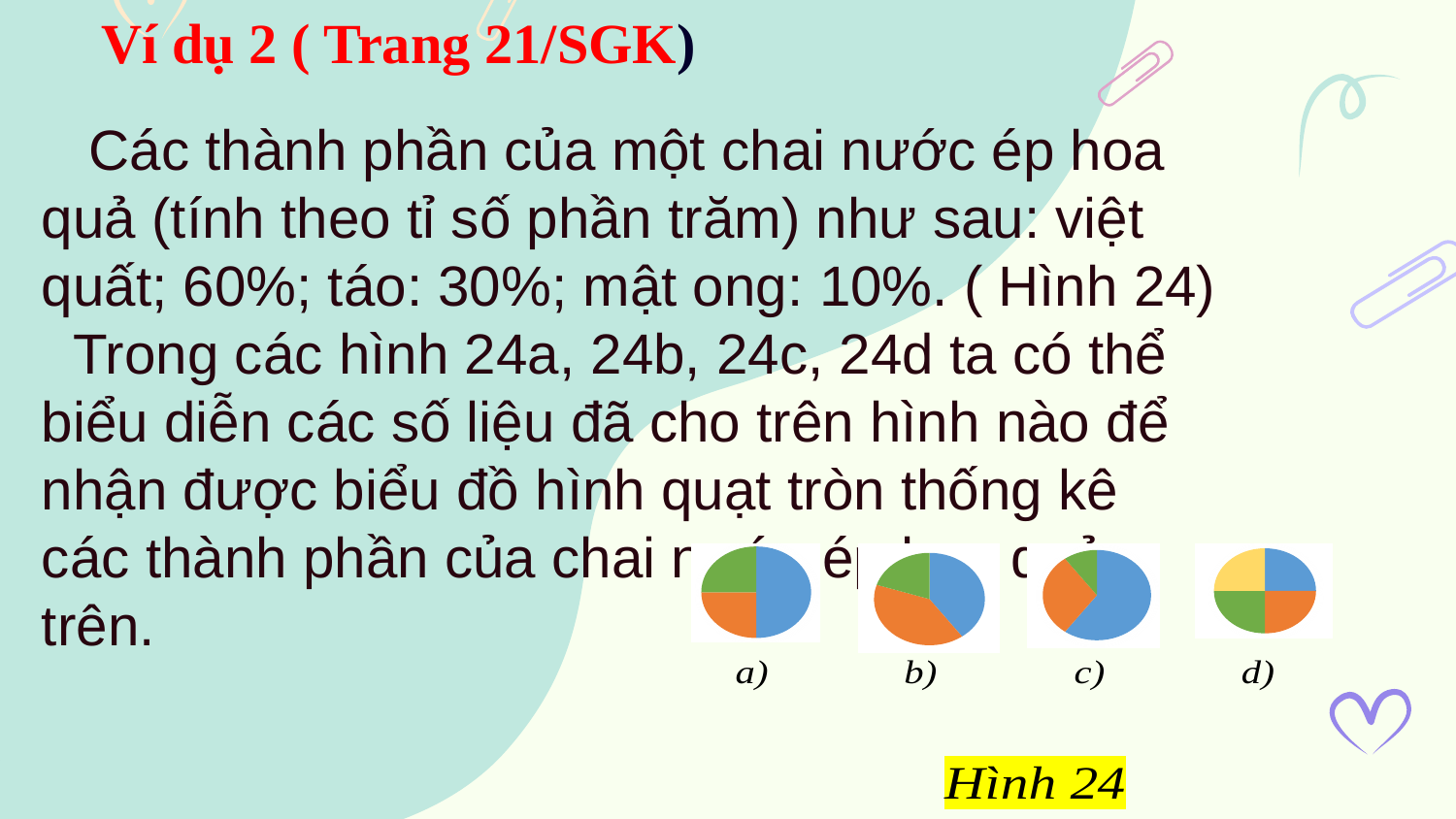
How many slices does pie chart c) have? 3 In pie chart c), which colour slice is the smallest? green How many slices does pie chart a) have? 3 In pie chart a), is the blue slice larger or smaller than the green slice? larger What kind of chart is chart a) on the slide? pie chart In pie chart b), which colour slice is the smallest? green How many slices does pie chart d) have? 4 In pie chart a), which colour slice is the largest? blue Which pie chart on the slide contains a yellow slice? d) What is the figure caption shown below the four pie charts? Hình 24 In pie chart c), which colour slice is the largest? blue